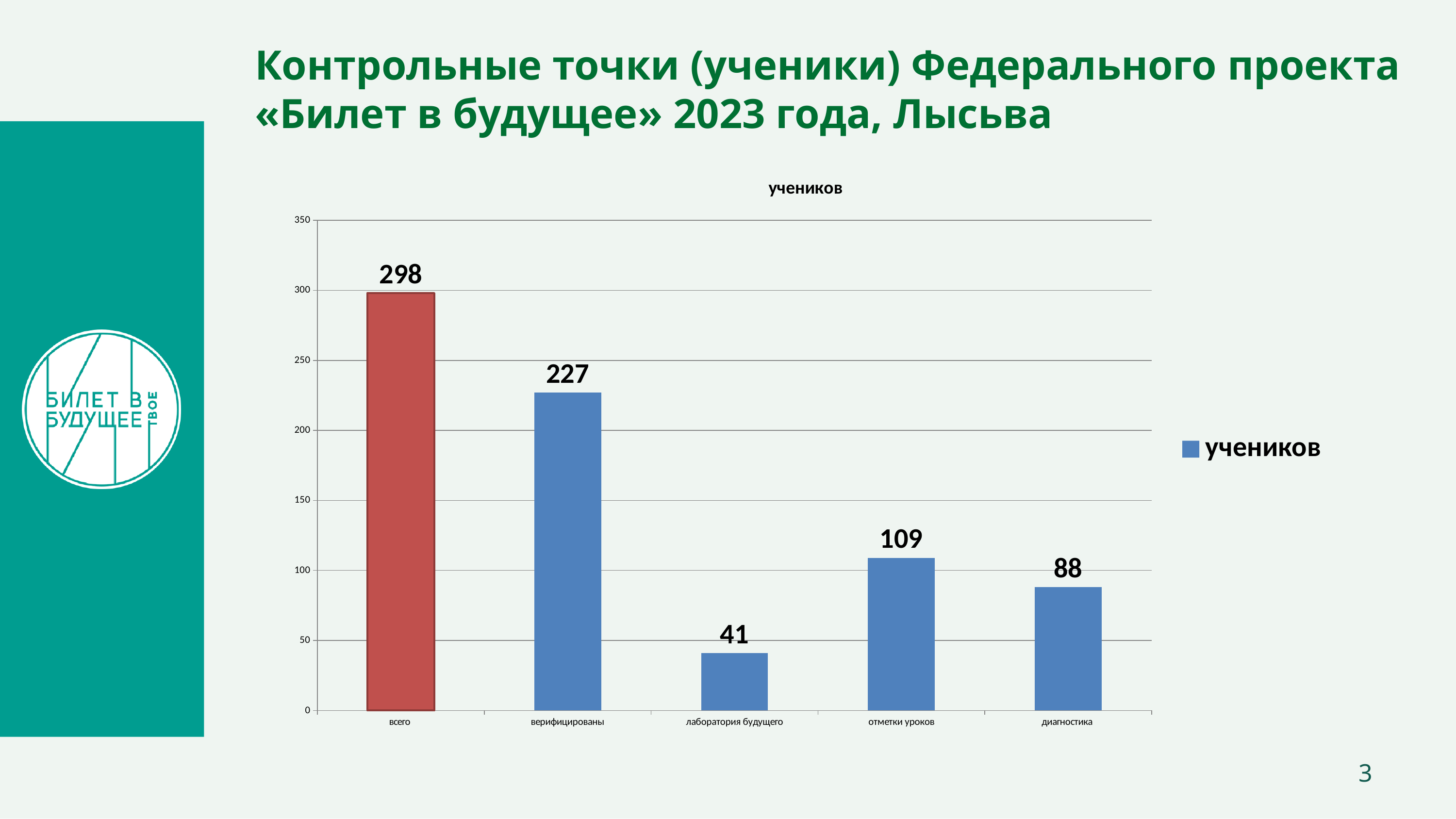
Which is larger, the value for отметки уроков or the value for диагностика? отметки уроков What is the difference between the values for всего and верифицированы? 71 What is the value for диагностика? 88 Which category has the lowest value? лаборатория будущего What is the value for лаборатория будущего? 41 What is the title of the chart? учеников How many categories are shown on the x axis? 5 Which category has the highest value? всего What kind of chart is shown on the slide? bar chart What is the value for верифицированы? 227 What is the value for отметки уроков? 109 What is the value for всего? 298